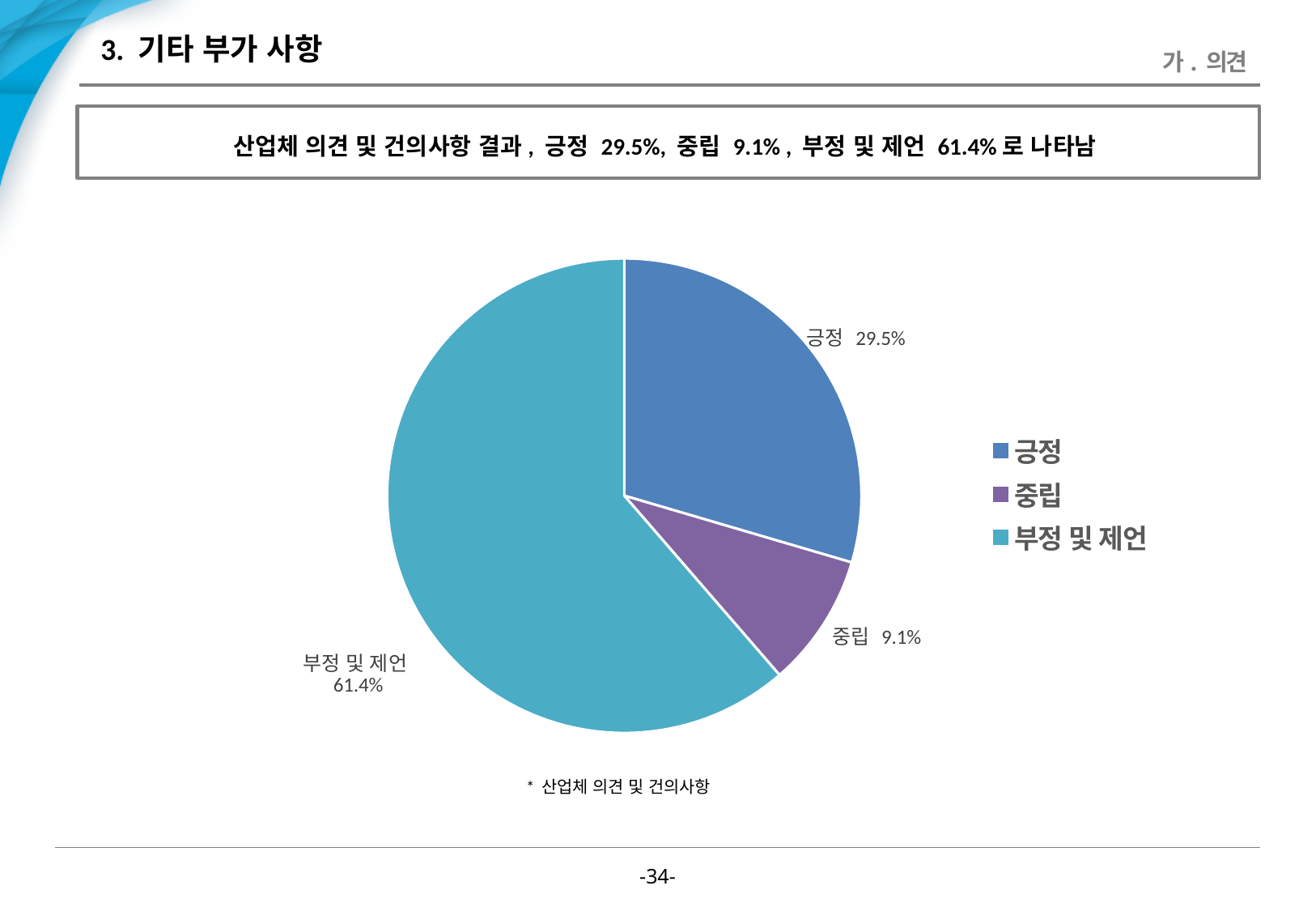
What is the value for 긍정 in the pie chart? 29.5% How many entries does the legend list? 3 What is the note printed below the pie chart? * 산업체 의견 및 건의사항 What is the value for 중립 in the pie chart? 9.1% Which category has the smallest slice of the pie chart? 중립 How many slices does the pie chart have? 3 What is the difference between the values for 부정 및 제언 and 긍정? 31.9% Which is larger, the slice for 긍정 or the slice for 중립? 긍정 What is the value for 부정 및 제언 in the pie chart? 61.4% What is the difference between the values for 긍정 and 중립? 20.4% Which category has the largest slice of the pie chart? 부정 및 제언 What kind of chart is shown on the slide? pie chart